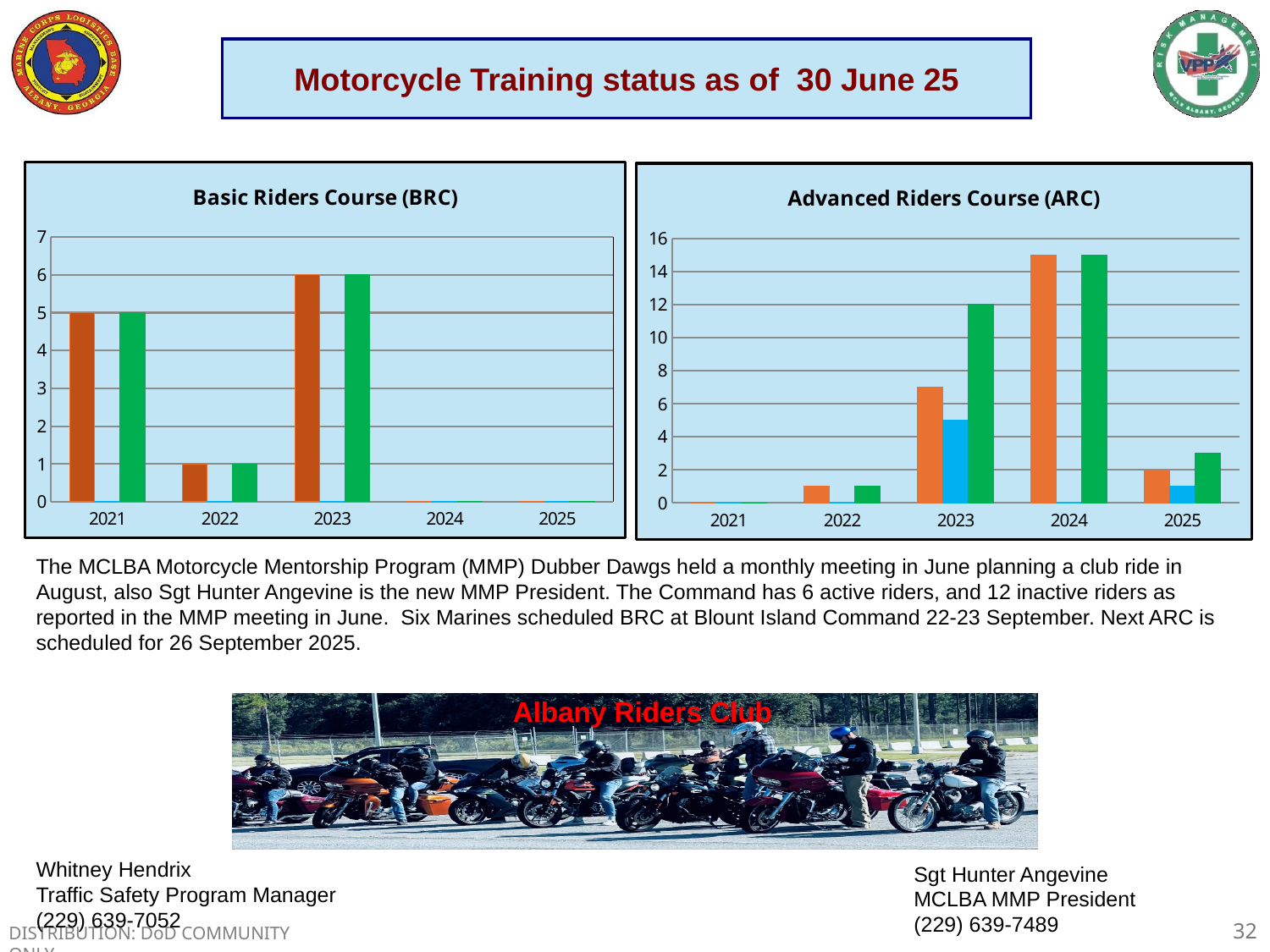
What kind of chart is the Basic Riders Course (BRC) chart? bar chart In the Advanced Riders Course (ARC) chart, which year has the tallest green bar? 2024 In the Basic Riders Course (BRC) chart, which year has the tallest orange bar? 2023 In the Basic Riders Course (BRC) chart, what is the value of the orange bar for 2023? 6 In the Basic Riders Course (BRC) chart, is the orange bar for 2021 larger than the orange bar for 2022? Yes How many years are shown on the x axis of the Advanced Riders Course (ARC) chart? 5 In the Advanced Riders Course (ARC) chart, is the orange bar for 2023 greater or less than 6? greater In the Advanced Riders Course (ARC) chart, what is the value of the green bar for 2023? 12 In the Basic Riders Course (BRC) chart, what is the value of the green bar for 2021? 5